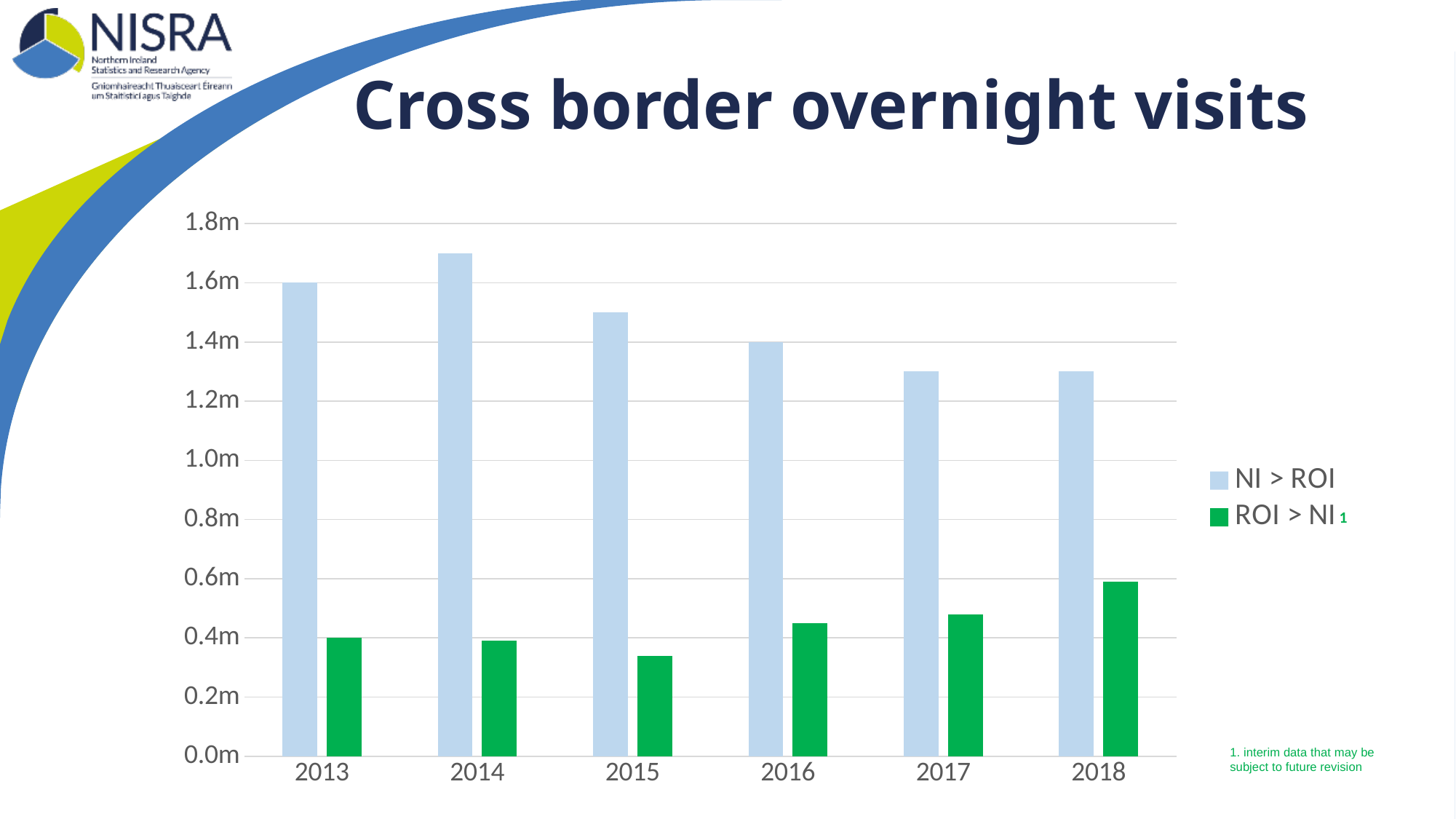
In which year is the NI > ROI value highest? 2014 What kind of chart is shown on the slide? Bar chart How many series does the legend list? 2 Is the ROI > NI value for 2018 greater or less than 0.4m? greater What is the title of the chart? Cross border overnight visits In which year is the ROI > NI value highest? 2018 Do the ROI > NI values rise or fall from 2015 to 2018? Rise Is the NI > ROI value for 2014 greater or less than 1.6m? greater Is the NI > ROI value for 2017 greater or less than 1.4m? less In which year is the ROI > NI value lowest? 2015 How many years are shown on the x axis? 6 In 2013, which is larger: NI > ROI or ROI > NI? NI > ROI